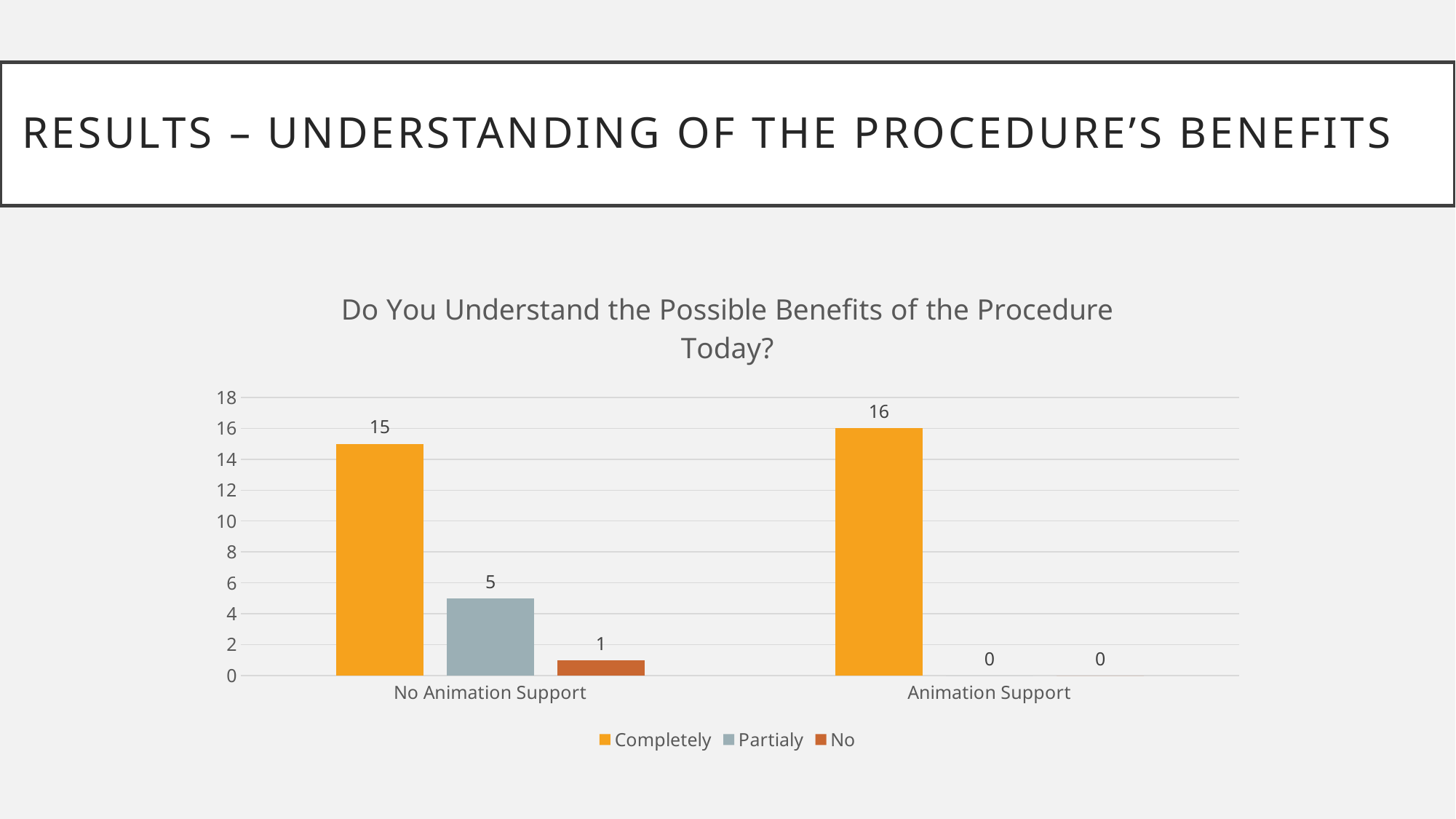
How many series does the legend list? 3 Which series has the lowest value in the No Animation Support group? No What is the value for Completely in the Animation Support group? 16 Which is larger: Partialy for No Animation Support or No for No Animation Support? Partialy for No Animation Support What is the difference between the Completely values for Animation Support and No Animation Support? 1 What kind of chart is shown on the slide? Bar chart What is the value for Partialy in the No Animation Support group? 5 What is the title of the chart? Do You Understand the Possible Benefits of the Procedure Today? Which series has the highest value in the No Animation Support group? Completely What is the value for Partialy in the Animation Support group? 0 What is the value for No in the No Animation Support group? 1 What is the value for Completely in the No Animation Support group? 15